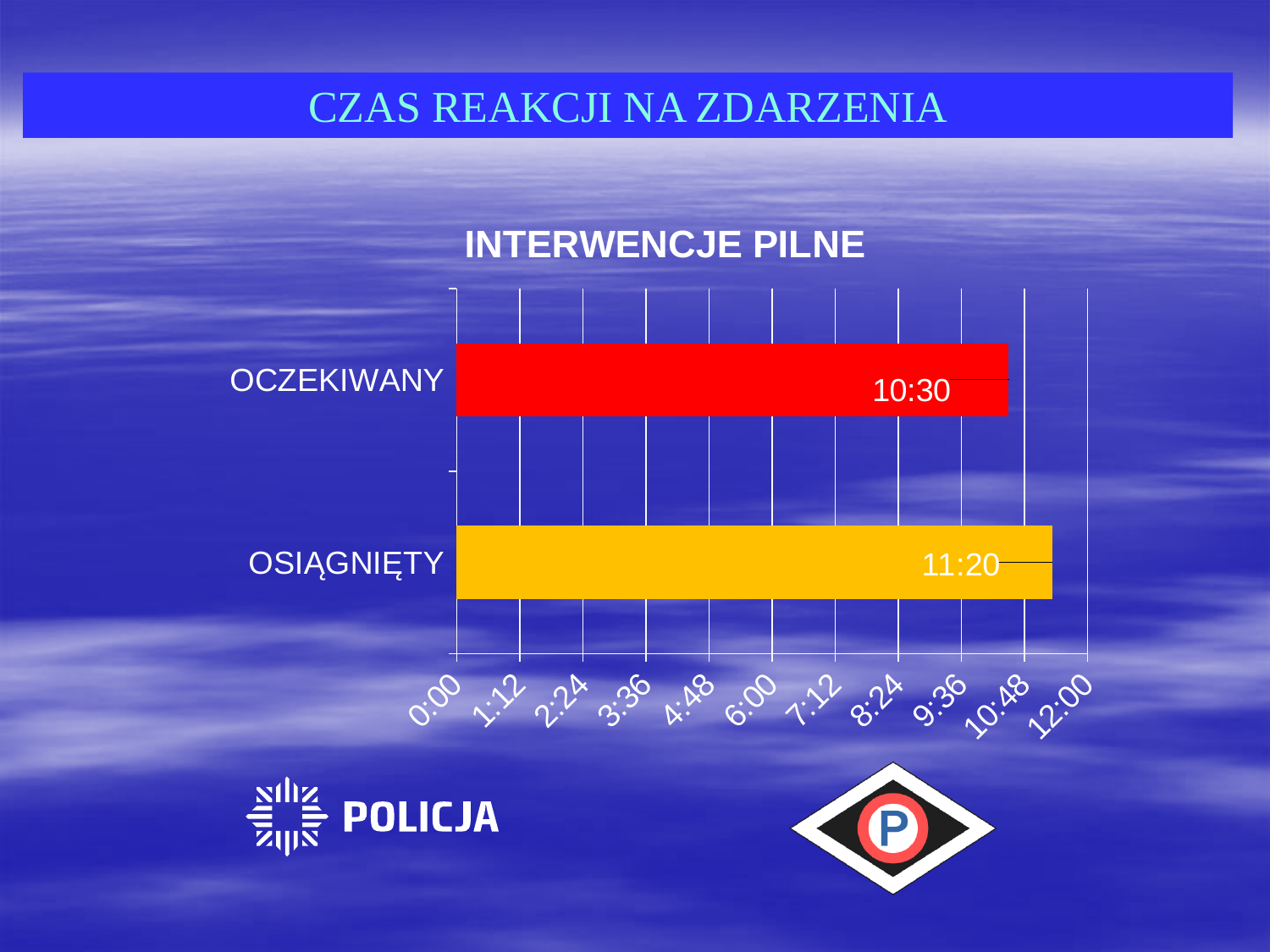
Which is larger in the INTERWENCJE PILNE chart, OCZEKIWANY or OSIĄGNIĘTY? OSIĄGNIĘTY What is the value for OCZEKIWANY in the INTERWENCJE PILNE chart? 10:30 Is the value for OSIĄGNIĘTY greater or less than 12:00? less What kind of chart is shown on the slide? bar chart What colour is the OSIĄGNIĘTY bar in the INTERWENCJE PILNE chart? yellow What is the title of the chart on the slide? INTERWENCJE PILNE Which category has the lowest value in the INTERWENCJE PILNE chart? OCZEKIWANY Is the value for OCZEKIWANY greater or less than 9:36? greater How many categories are shown in the INTERWENCJE PILNE chart? 2 What is the value for OSIĄGNIĘTY in the INTERWENCJE PILNE chart? 11:20 What is the difference between the OSIĄGNIĘTY and OCZEKIWANY values in the INTERWENCJE PILNE chart? 0:50 Which category has the highest value in the INTERWENCJE PILNE chart? OSIĄGNIĘTY